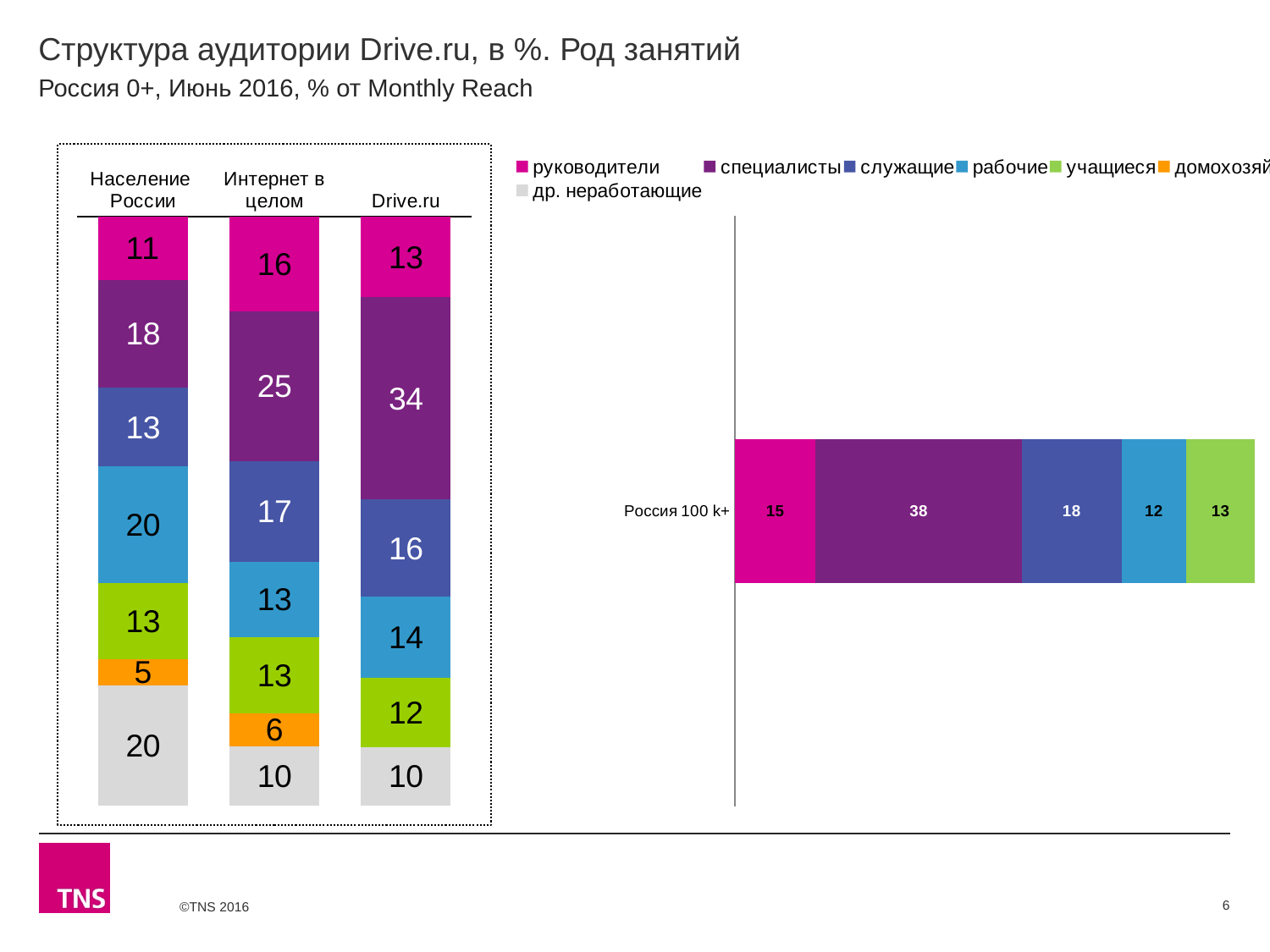
How many columns (categories) are shown in the left chart? 3 In the left chart, what is the value of the рабочие segment for Интернет в целом? 13 In the left chart, what is the difference between the специалисты values for Drive.ru and Население России? 16 In the right chart (Россия 100 k+), what is the value of the руководители segment? 15 How many series does the legend list? 7 In the left chart, which of the three columns has the largest специалисты segment? Drive.ru In the left chart, what is the value of the руководители segment for Население России? 11 In the left chart, what is the value of the специалисты segment for Drive.ru? 34 What kind of chart is the right chart? Stacked bar chart In the left chart, which is larger: the служащие value for Интернет в целом or for Drive.ru? Интернет в целом In the right chart (Россия 100 k+), what is the value of the специалисты segment? 38